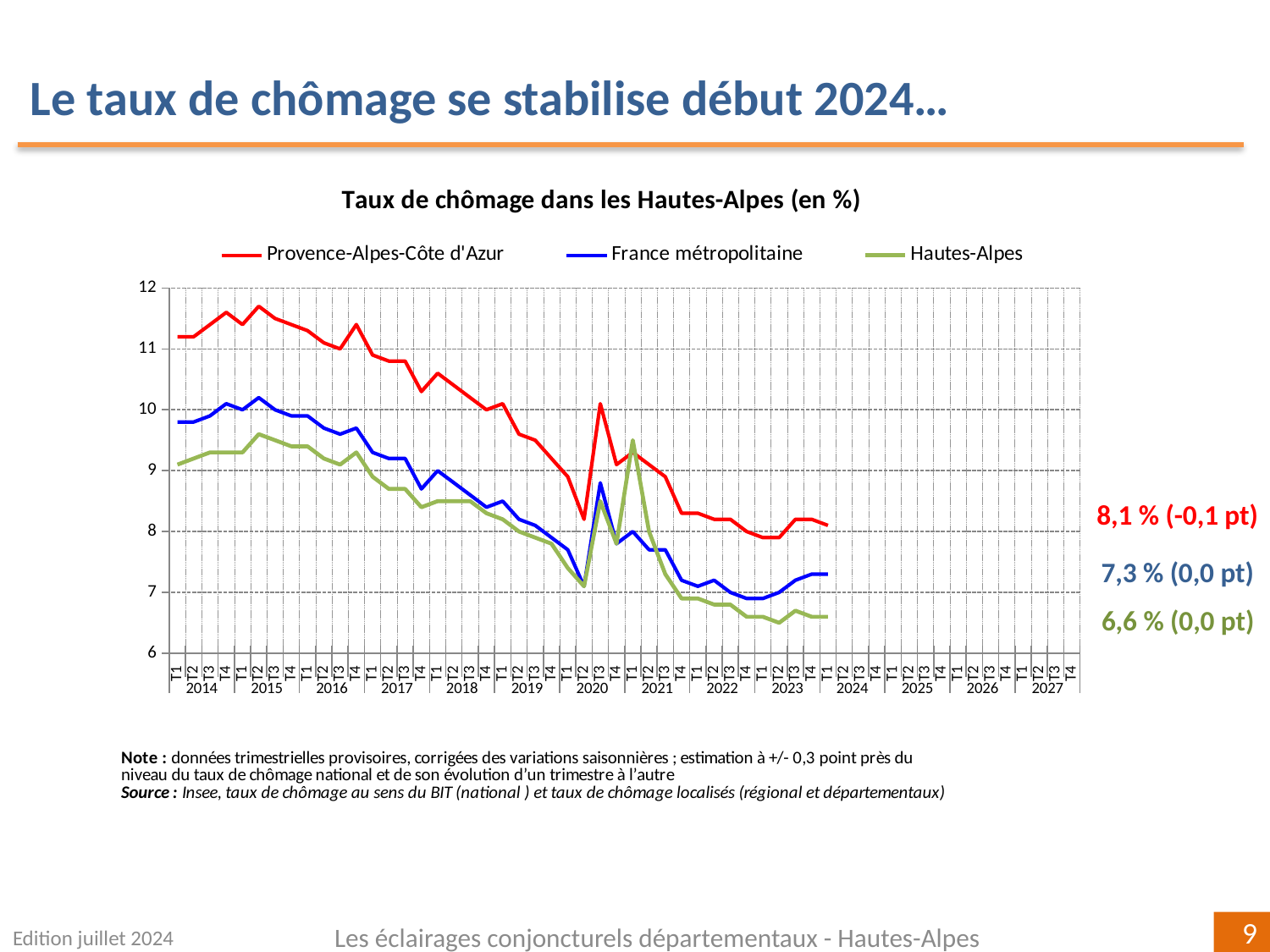
What is the title of the chart? Taux de chômage dans les Hautes-Alpes (en %) What is the quarterly change shown for the latest Provence-Alpes-Côte d'Azur value? -0,1 pt What is the difference between the latest Provence-Alpes-Côte d'Azur rate and the latest Hautes-Alpes rate? 1,5 points Is the value for Provence-Alpes-Côte d'Azur in T2 2015 greater or less than 11? greater Which series has the lowest value at the end of the period? Hautes-Alpes Does the Provence-Alpes-Côte d'Azur series rise or fall overall between 2014 and 2024? fall What is the latest unemployment rate shown for Hautes-Alpes? 6,6 % How many series does the legend list? 3 What is the latest unemployment rate shown for France métropolitaine? 7,3 % Which series has the highest value at the end of the period? Provence-Alpes-Côte d'Azur What kind of chart is shown on the slide? line chart What is the latest unemployment rate shown for Provence-Alpes-Côte d'Azur? 8,1 %